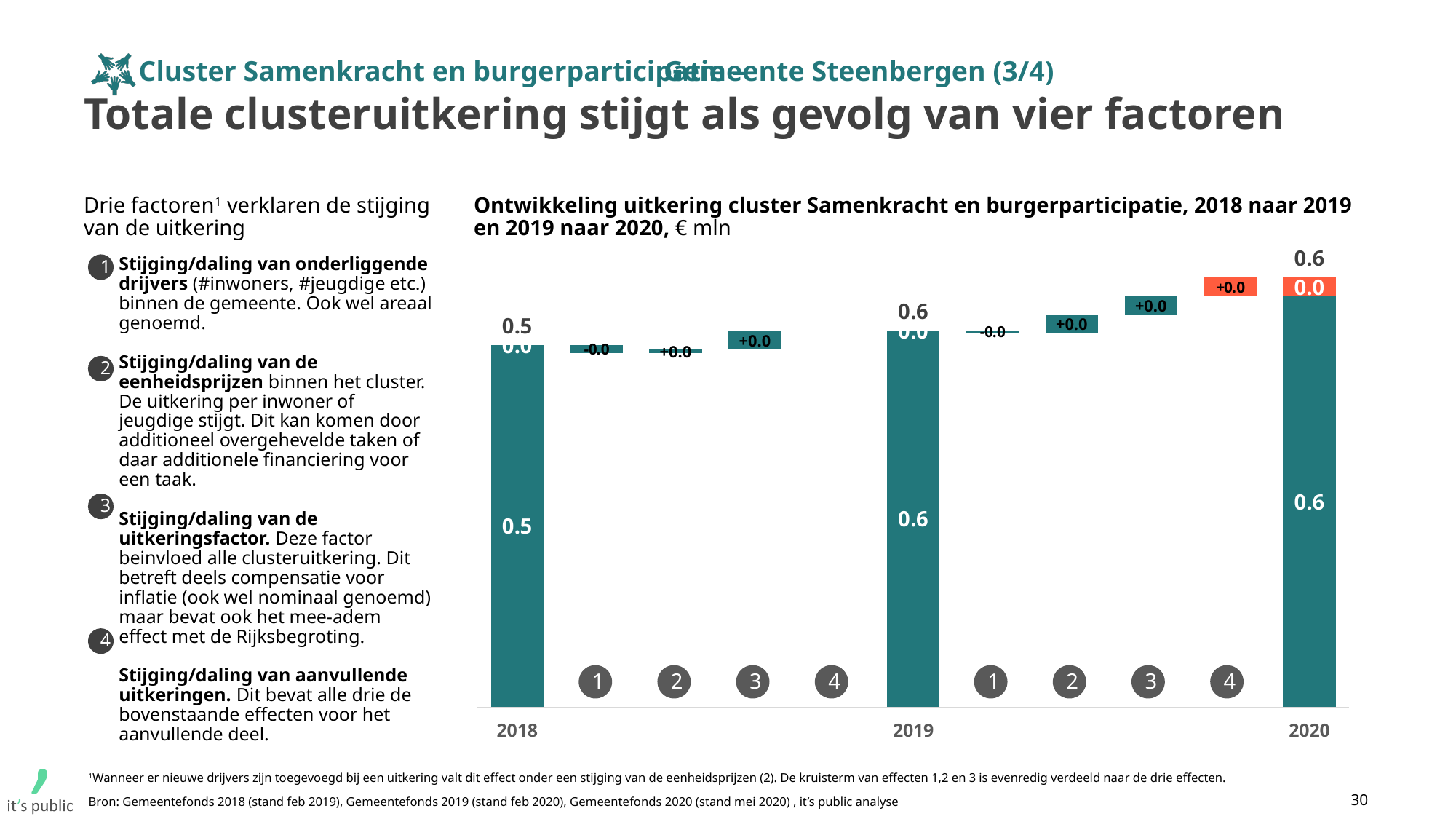
What is the value of the large teal segment of the 2020 bar? 0.6 By how much does the total rise from 2018 to 2019? 0.1 What is the label on the factor 4 step between 2019 and 2020? +0.0 What is the total value shown above the 2019 bar? 0.6 What is the value of the large teal segment of the 2018 bar? 0.5 Which year has the lowest total cluster payment? 2018 What is the label on the factor 1 step between 2018 and 2019? -0.0 In what unit are the values in the chart expressed? € mln What kind of chart is shown on the slide? Bar chart (waterfall) Is the total for 2019 larger or smaller than the total for 2018? larger What is the total value shown above the 2020 bar? 0.6 What is the total value shown above the 2018 bar? 0.5